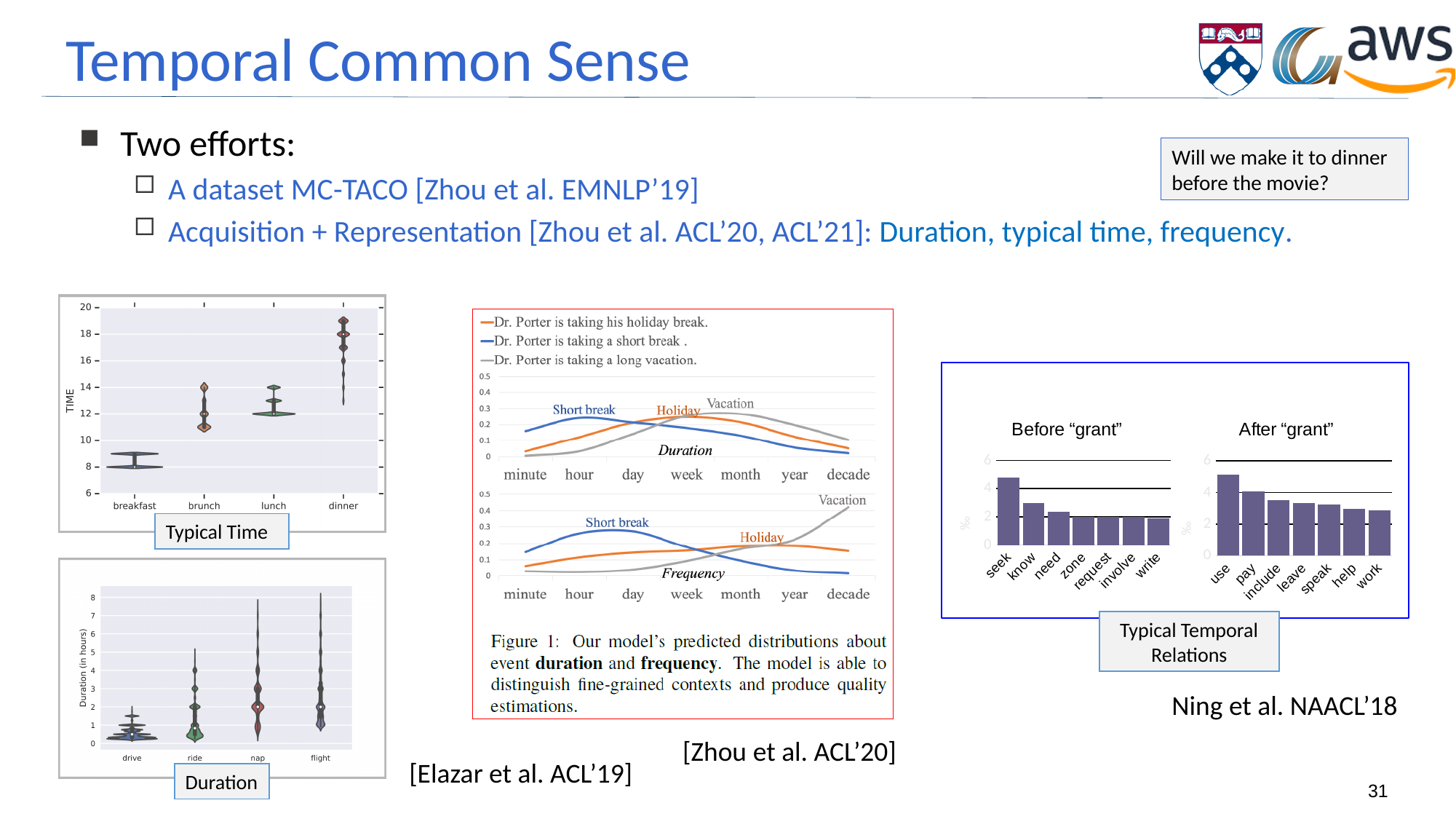
In the Typical Time chart, which meal has the highest time values? dinner How many series does the legend of the Duration/Frequency chart (Figure 1) list? 3 In the Before "grant" chart, which verb has the tallest bar? seek In the After "grant" chart, which verb has the tallest bar? use In the Before "grant" chart, is the value for seek greater or less than 4? greater How many verbs are shown on the x axis of the After "grant" chart? 7 What kind of chart is the Before "grant" chart? bar chart How many time units are shown on the x axis of the Duration panel in Figure 1? 7 How many categories are shown on the x axis of the Duration violin chart? 4 In the After "grant" chart, is the value for help greater or less than 4? less In the Before "grant" chart, is the value for know greater or less than 4? less In the Before "grant" chart, which bar is taller, seek or write? seek